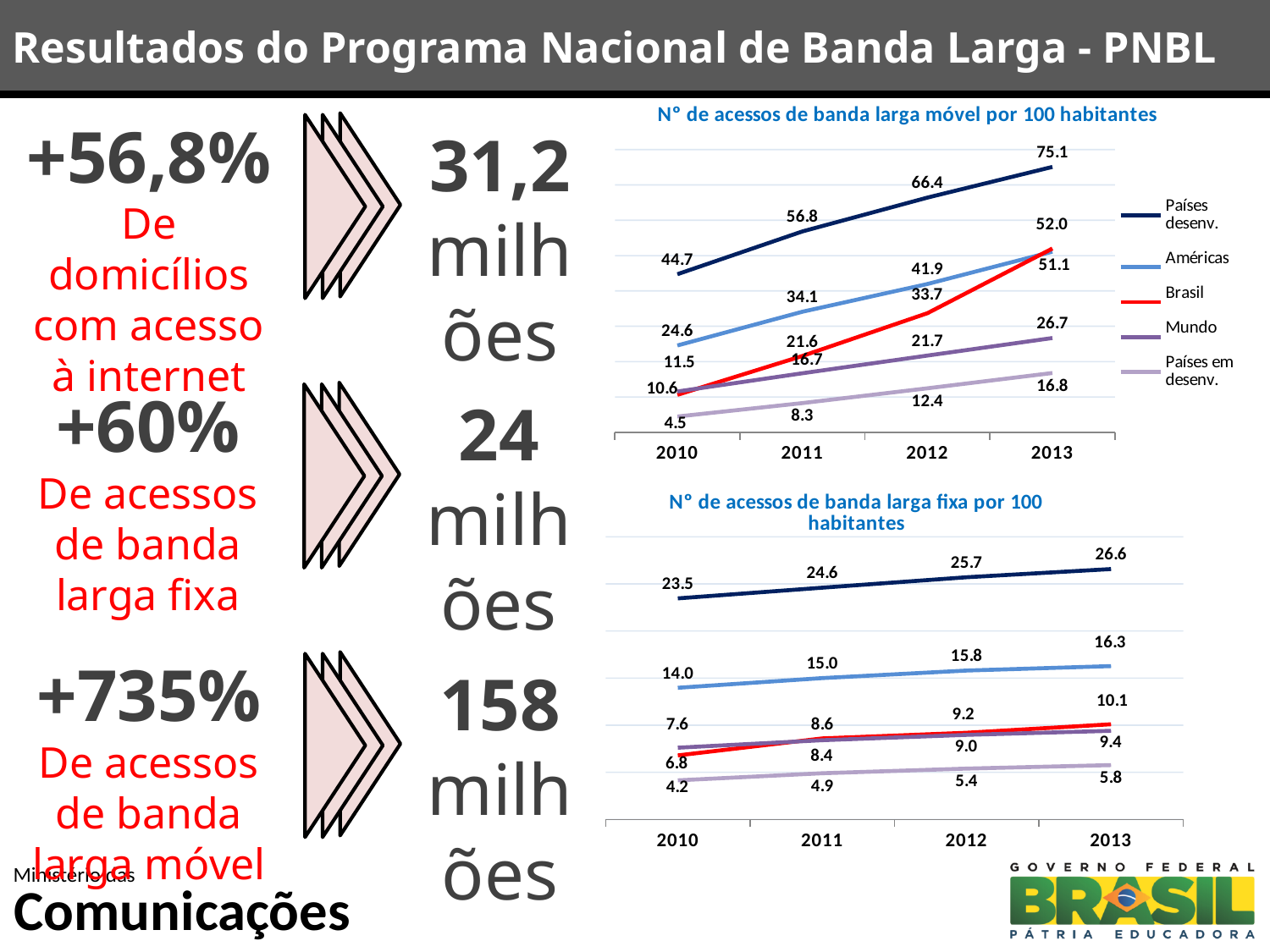
In the chart 'N° de acessos de banda larga móvel por 100 habitantes', by how much did the value for Brasil increase from 2010 to 2013? 41.4 What kind of chart is 'N° de acessos de banda larga fixa por 100 habitantes'? Line chart In the chart 'N° de acessos de banda larga móvel por 100 habitantes', which series has the highest value in 2013? Países desenv. In the chart 'N° de acessos de banda larga fixa por 100 habitantes', does the top (dark blue) line rise or fall from 2010 to 2013? Rise In the chart 'N° de acessos de banda larga móvel por 100 habitantes', what is the value for Brasil in 2013? 52.0 In the chart 'N° de acessos de banda larga móvel por 100 habitantes', what is the value for Países desenv. in 2010? 44.7 How many series does the legend of the chart 'N° de acessos de banda larga móvel por 100 habitantes' list? 5 In the chart 'N° de acessos de banda larga móvel por 100 habitantes', which is larger in 2012: Brasil or Mundo? Brasil In the chart 'N° de acessos de banda larga fixa por 100 habitantes', what is the value of the top (dark blue) line in 2013? 26.6 How many years are shown on the x axis of the chart 'N° de acessos de banda larga fixa por 100 habitantes'? 4 In the chart 'N° de acessos de banda larga fixa por 100 habitantes', what is the lowest value shown in 2010? 4.2 In the chart 'N° de acessos de banda larga móvel por 100 habitantes', which series has the lowest value in 2010? Países em desenv.